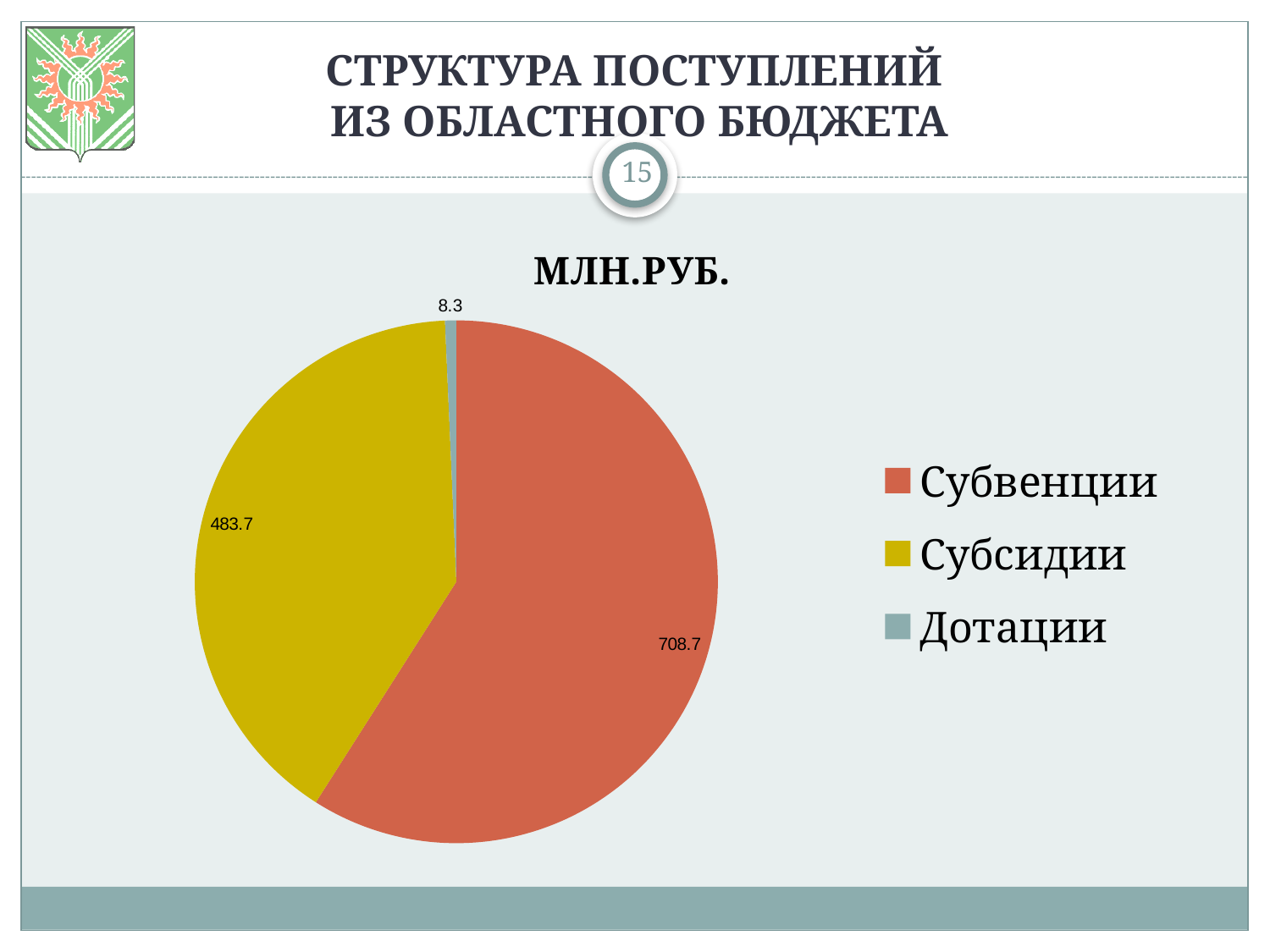
What is the value for Субсидии? 483.7 What is the value for Дотации? 8.3 What kind of chart is shown on the slide? Pie chart Which category has the smallest slice of the pie? Дотации What is the value for Субвенции? 708.7 What is the difference between the values for Субвенции and Субсидии? 225.0 What is the difference between the values for Субсидии and Дотации? 475.4 What is the title of the chart? МЛН.РУБ. Which is larger, Субвенции or Субсидии? Субвенции Which category has the largest slice of the pie? Субвенции How many categories does the pie chart have? 3 What is the total of all slices in the pie chart? 1200.7